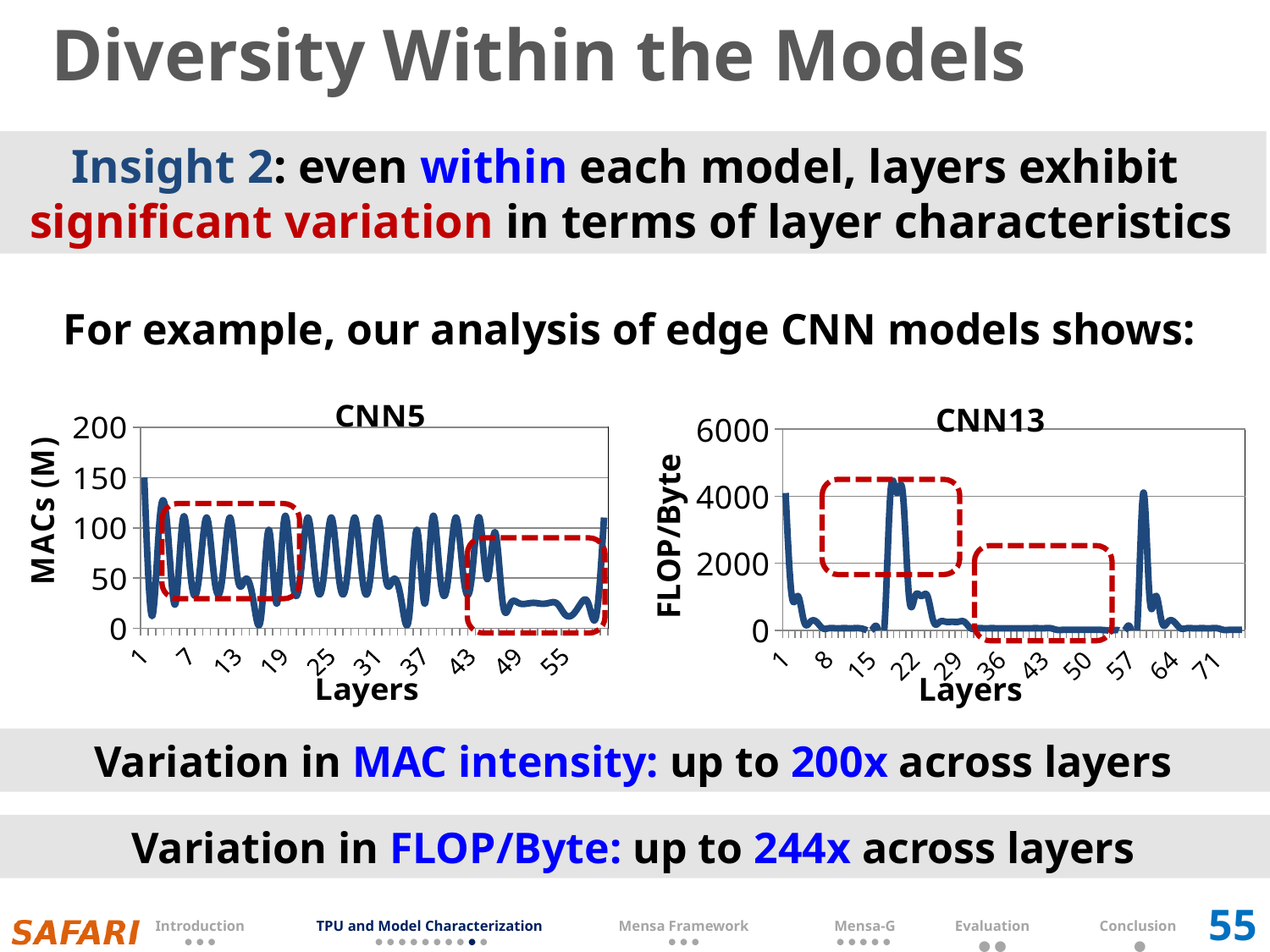
In the CNN5 chart, is the value for layer 1 greater or less than 100? greater In the CNN5 chart, is the value for layer 49 greater or less than 50? less In the CNN5 chart, is the value for layer 49 higher or lower than the value for layer 1? lower In the CNN5 chart, is the value for layer 55 greater or less than 100? less In the CNN13 chart, is the value for layer 1 higher or lower than the value for layer 36? higher What is the y-axis label of the CNN5 chart? MACs (M) What is the y-axis label of the CNN13 chart? FLOP/Byte What kind of chart is the CNN5 chart on the left? line chart What kind of chart is the CNN13 chart on the right? line chart